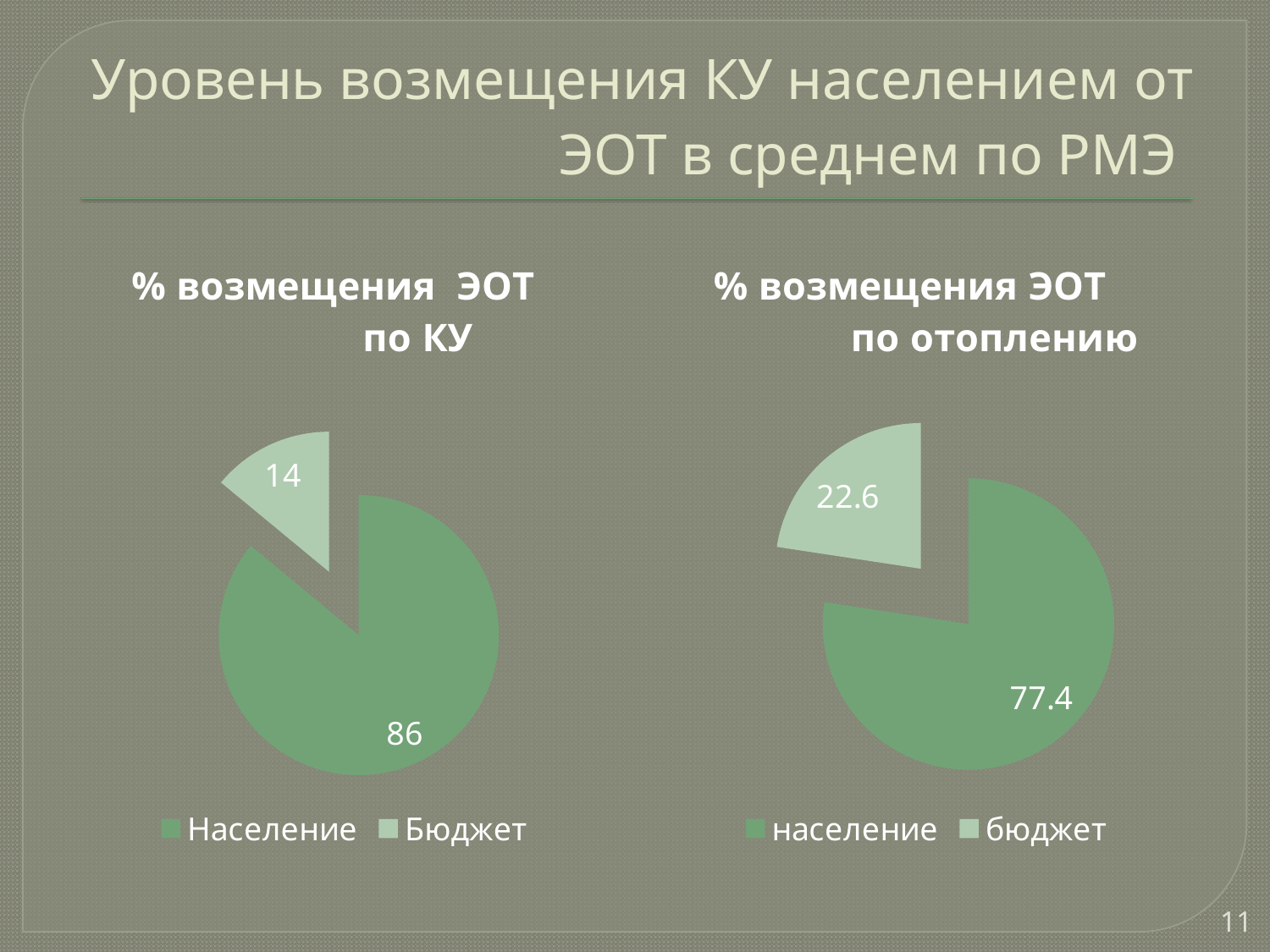
In the chart titled "% возмещения ЭОТ по КУ", what is the value for Население? 86 How many slices does the chart titled "% возмещения ЭОТ по отоплению" have? 2 In the chart titled "% возмещения ЭОТ по КУ", what is the difference between the values for Население and Бюджет? 72 In the chart titled "% возмещения ЭОТ по отоплению", what is the value for бюджет? 22.6 What type of chart is the left chart, "% возмещения ЭОТ по КУ"? Pie chart In the chart titled "% возмещения ЭОТ по отоплению", which category has the smallest slice? бюджет Which is larger: the бюджет value in the chart "% возмещения ЭОТ по отоплению" or the Бюджет value in the chart "% возмещения ЭОТ по КУ"? бюджет in "% возмещения ЭОТ по отоплению" (22.6) In the chart titled "% возмещения ЭОТ по отоплению", what is the difference between the values for население and бюджет? 54.8 In the chart titled "% возмещения ЭОТ по КУ", what is the value for Бюджет? 14 How many entries does the legend of the chart titled "% возмещения ЭОТ по КУ" list? 2 In the chart titled "% возмещения ЭОТ по КУ", which category has the largest slice? Население In the chart titled "% возмещения ЭОТ по отоплению", what is the value for население? 77.4